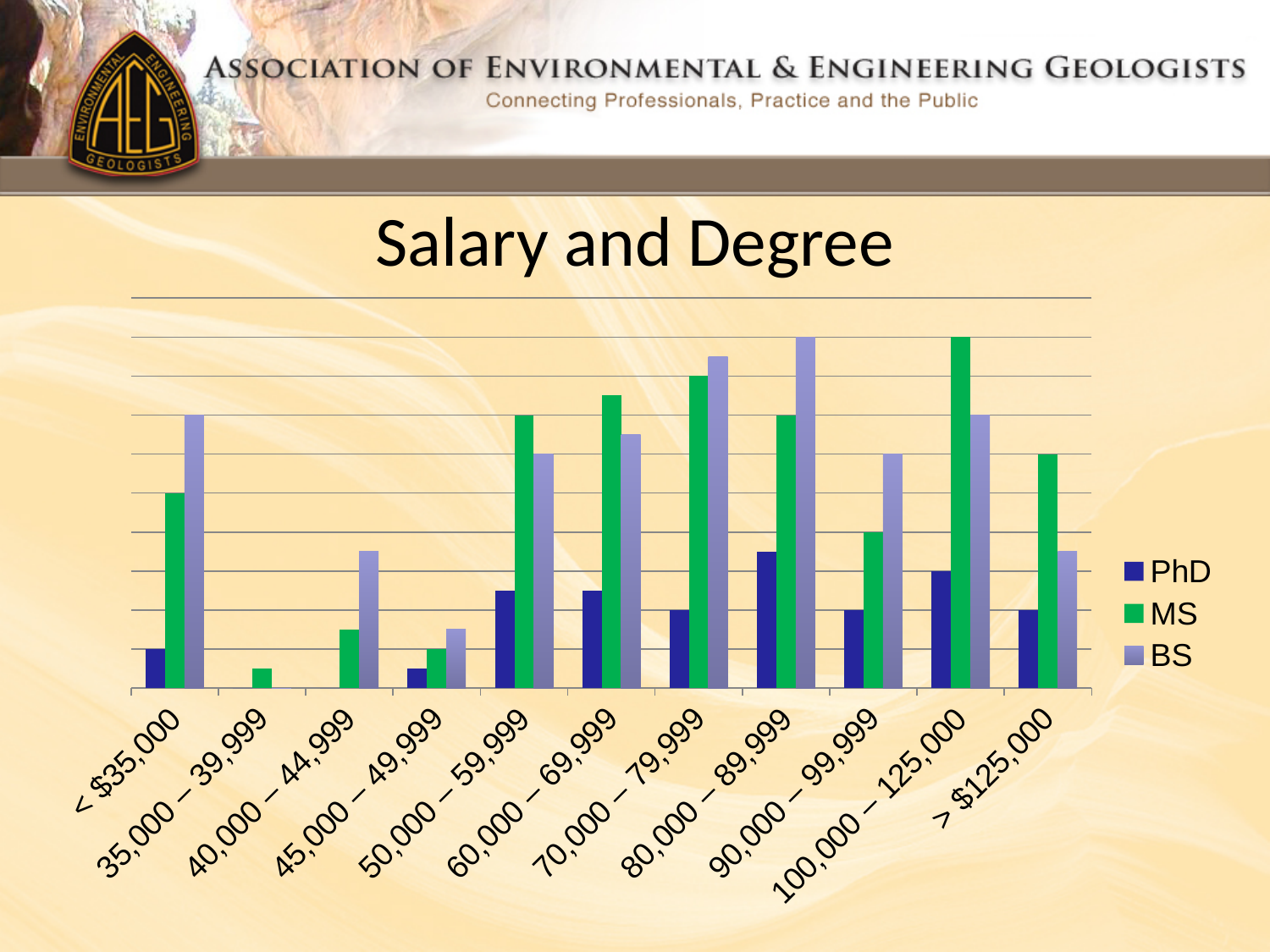
In the 100,000 – 125,000 category, which is larger, the MS bar or the BS bar? MS In the < $35,000 category, which is larger, the BS bar or the MS bar? BS How many salary categories are shown on the x axis? 11 In which salary category is the PhD bar the tallest? 80,000 – 89,999 Which colour represents the MS series in the legend? green In which salary category is the MS bar the tallest? 100,000 – 125,000 What kind of chart is shown on the slide? bar chart What is the title of the chart? Salary and Degree In the > $125,000 category, which is larger, the MS bar or the PhD bar? MS How many series does the legend list? 3 In which salary category is the BS bar the tallest? 80,000 – 89,999